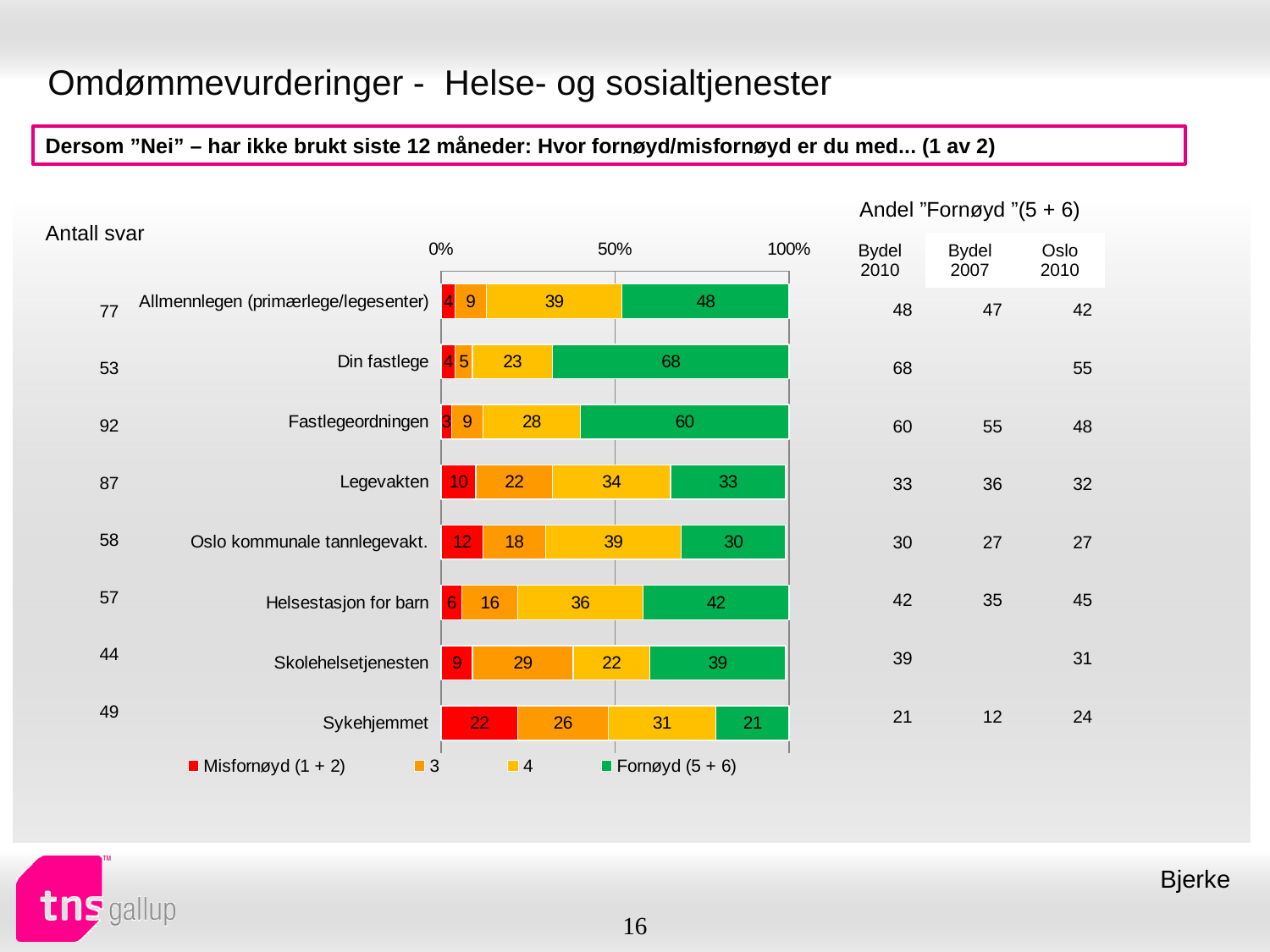
What is the "Fornøyd (5 + 6)" value for Din fastlege? 68 What is the "Misfornøyd (1 + 2)" value for Sykehjemmet? 22 Which category has the highest "Fornøyd (5 + 6)" value? Din fastlege What is the total of the stacked bar for Sykehjemmet? 100 How many categories are shown in the bar chart? 8 How many series does the legend list? 4 What is the value of series "4" for Legevakten? 34 Which has a larger "Misfornøyd (1 + 2)" value, Legevakten or Oslo kommunale tannlegevakt.? Oslo kommunale tannlegevakt. Which category has the lowest "Fornøyd (5 + 6)" value? Sykehjemmet What is the difference between the "Fornøyd (5 + 6)" values for Fastlegeordningen and Legevakten? 27 What kind of chart is shown on the slide? Stacked bar chart What is the value of series "3" for Skolehelsetjenesten? 29